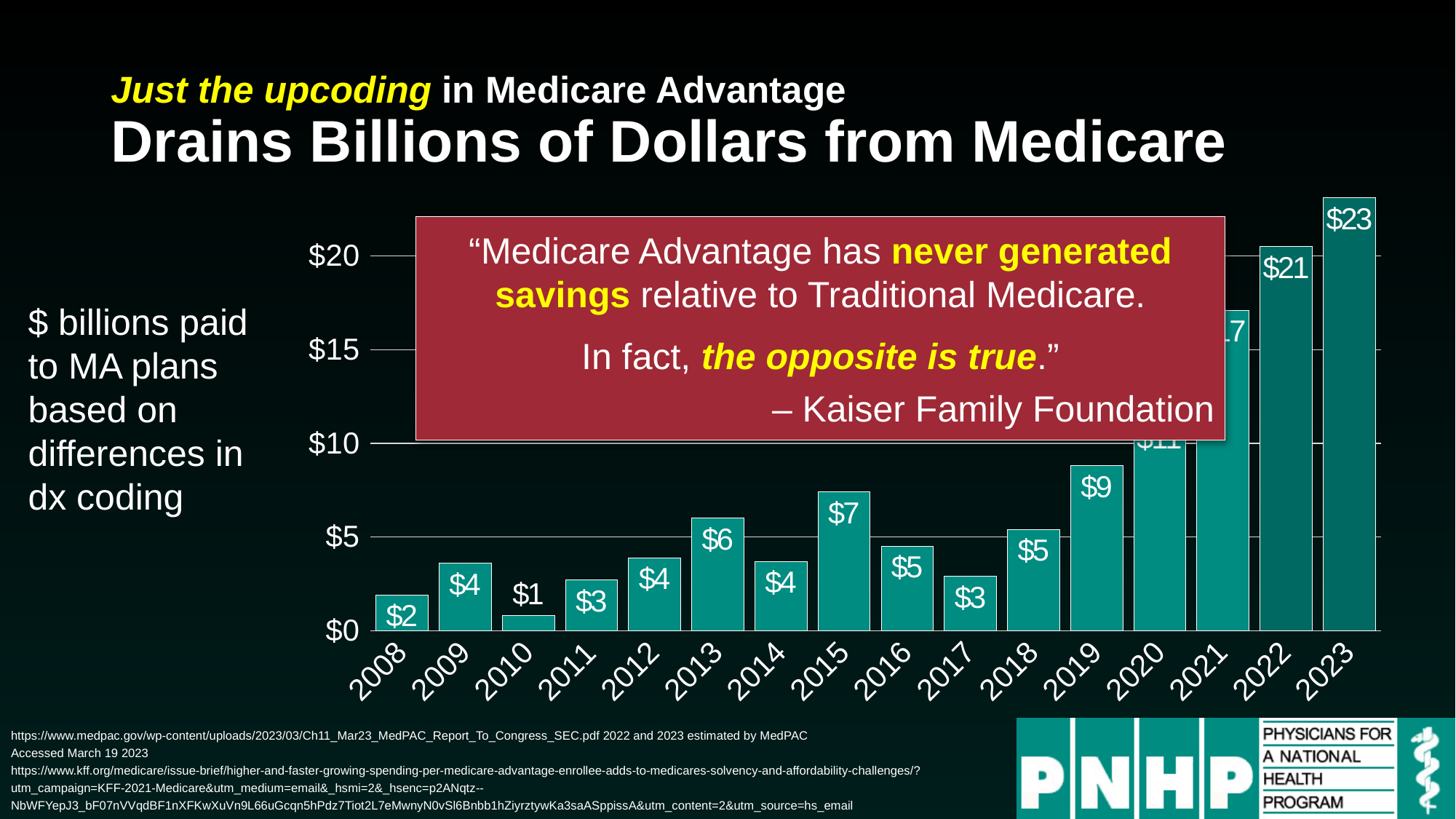
Which is larger, the value for 2019 or the value for 2018? 2019 What is the value shown for 2023? $23 What kind of chart is shown? bar chart Is the value for 2021 greater or less than $15? greater What is the value shown for 2015? $7 How many years are shown on the x axis? 16 What is the value shown for 2019? $9 What is the difference between the values for 2023 and 2022? $2 Do the values generally rise or fall from 2008 to 2023? rise Which year has the lowest value? 2010 Which year has the highest value? 2023 What is the value shown for 2010? $1